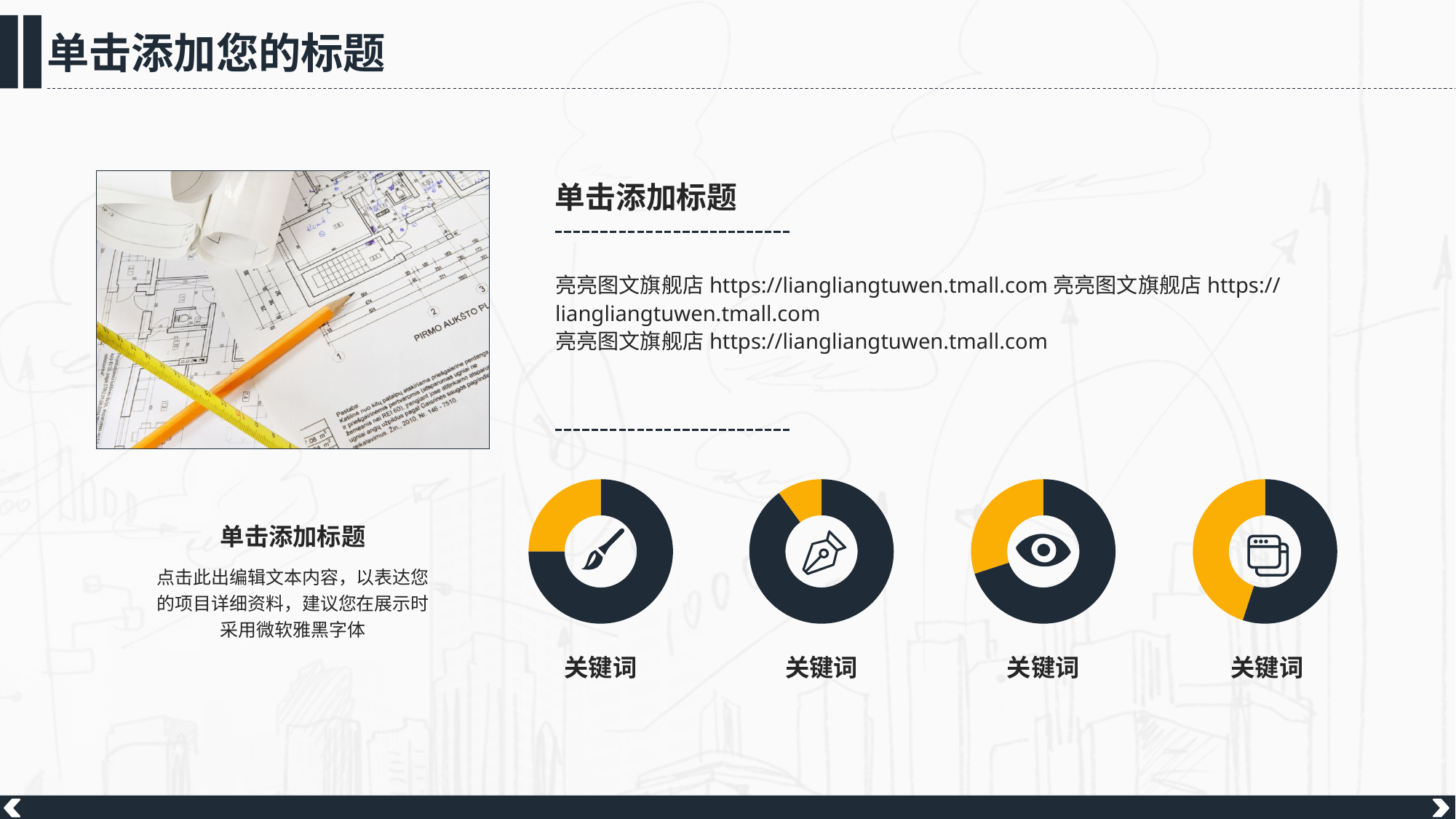
In the second donut chart from the left (with the pen nib icon), which slice is larger, the yellow one or the dark one? The dark one Which of the four donut charts has the largest yellow slice? The rightmost one (with the window icon) What two colours are used for the slices of the donut charts? Yellow and dark navy Is the yellow slice in the second donut chart from the left greater or less than 25% of the donut? less How many donut charts are shown on the slide? 4 How many slices does each donut chart at the bottom of the slide have? 2 Which of the four donut charts has the smallest yellow slice? The second from the left (with the pen nib icon) In the leftmost donut chart (with the brush icon), which slice is larger, the yellow one or the dark one? The dark one What label appears under each of the four donut charts? 关键词 Is the yellow slice in the rightmost donut chart greater or less than 25% of the donut? greater What kind of chart is used for the four charts at the bottom of the slide? Donut (pie) chart In the third donut chart from the left (with the eye icon), which slice is larger, the yellow one or the dark one? The dark one